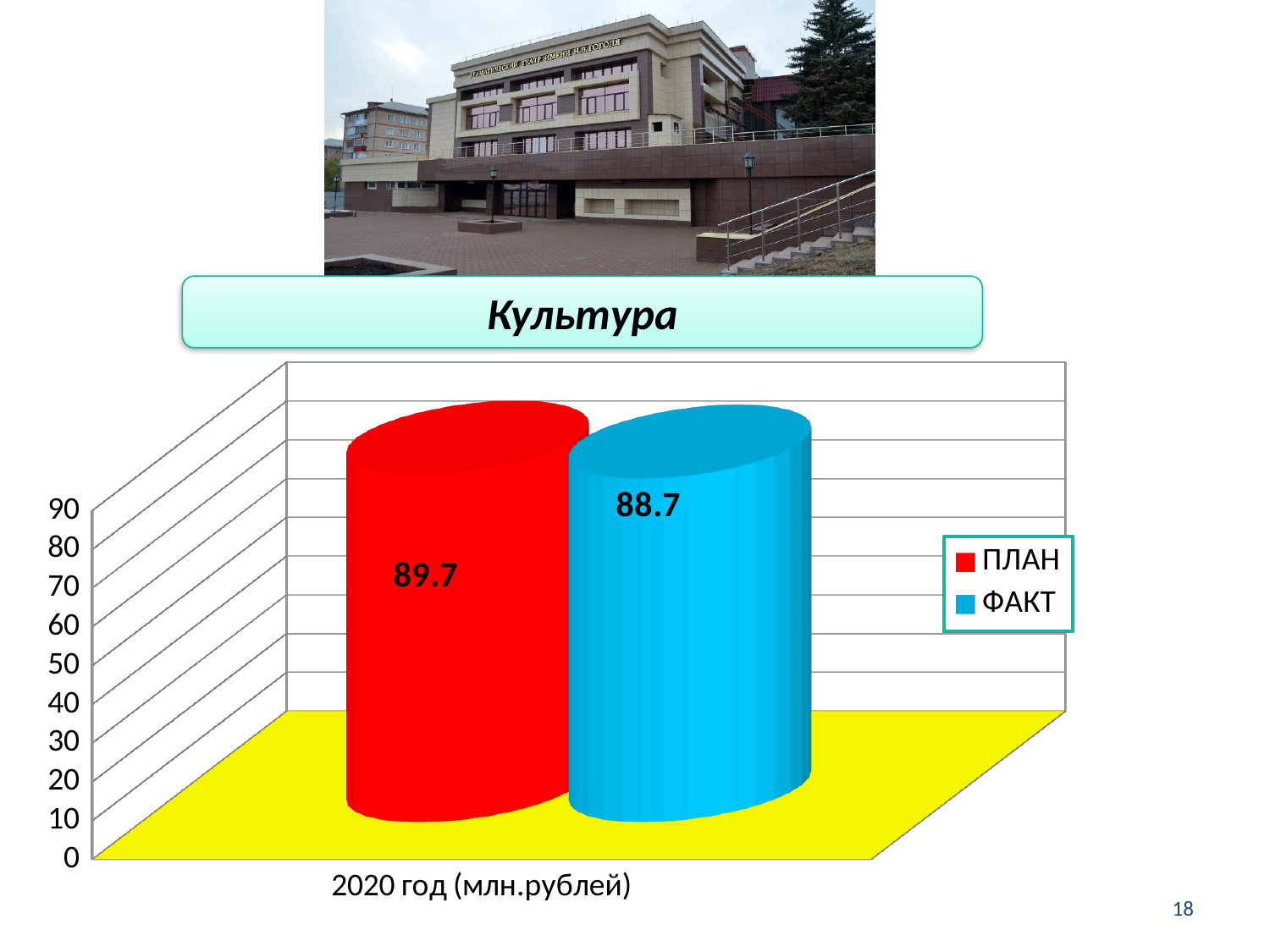
What is the value of ФАКТ for 2020 год (млн.рублей)? 88.7 Is the value for ФАКТ greater or less than 80? greater How many series does the legend list? 2 Which series has the higher value, ПЛАН or ФАКТ? ПЛАН What colour is the ФАКТ bar in the chart? blue What is the highest value shown on the chart's vertical axis? 90 What kind of chart is shown on the slide? bar chart What is the category label on the x axis of the chart? 2020 год (млн.рублей) How many categories are shown on the x axis of the chart? 1 Which series has the lowest value in the chart? ФАКТ What is the difference between the ПЛАН and ФАКТ values? 1.0 What is the value of ПЛАН for 2020 год (млн.рублей)? 89.7